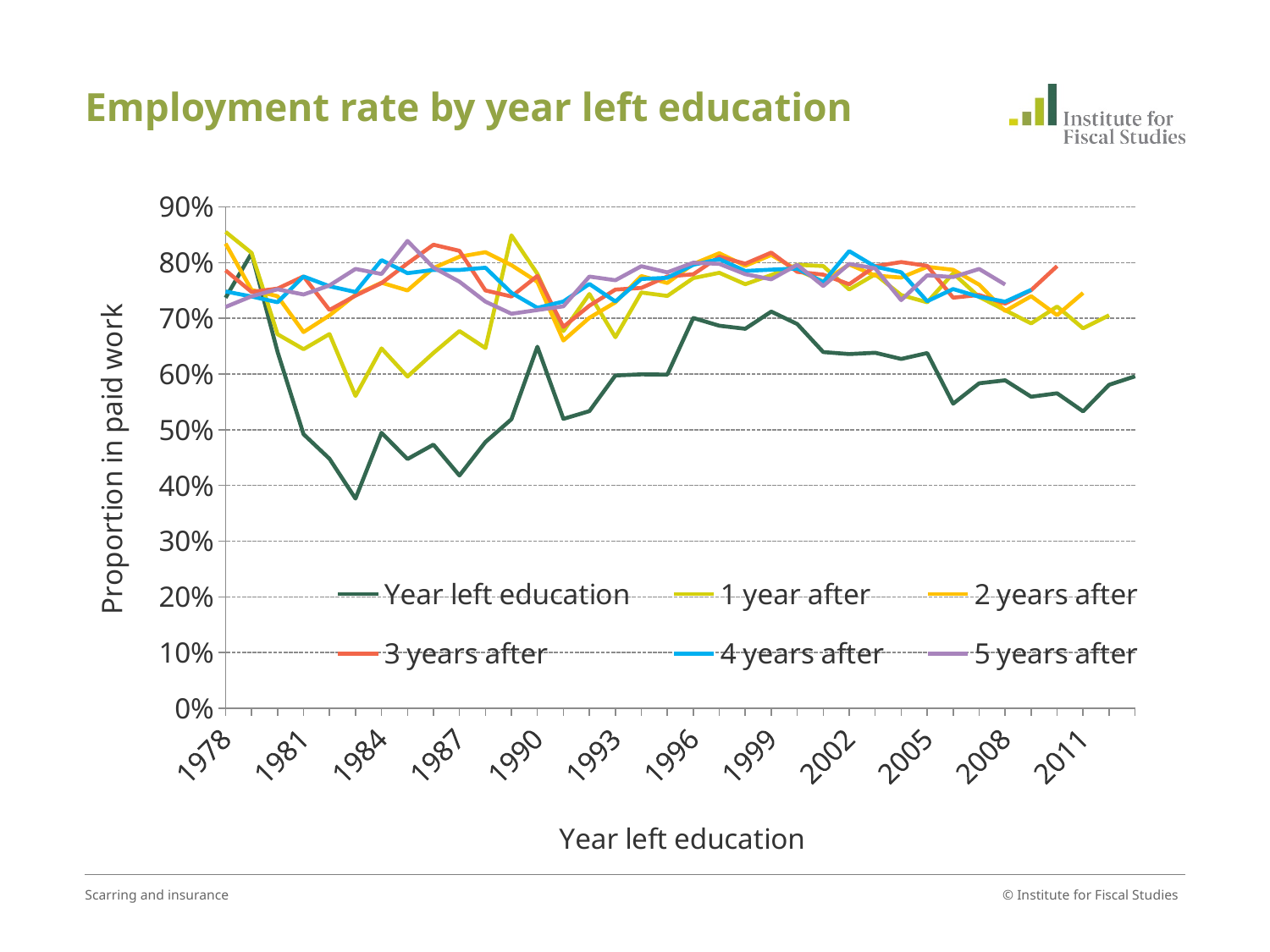
Is the value for the 'Year left education' series in 1983 greater or less than 50%? less What is the label on the vertical axis? Proportion in paid work How many year labels are shown on the horizontal axis? 12 Is the value for the '1 year after' series in 1983 greater or less than 70%? less In 1983, which series has the higher value: 'Year left education' or '3 years after'? 3 years after What kind of chart is shown on the slide? line chart How many series does the legend list? 6 Is the value for the 'Year left education' series in 2011 greater or less than 60%? less Does the 'Year left education' series rise or fall between 1979 and 1983? fall Which series has the lowest values across most of the chart? Year left education What is the title of the chart? Employment rate by year left education